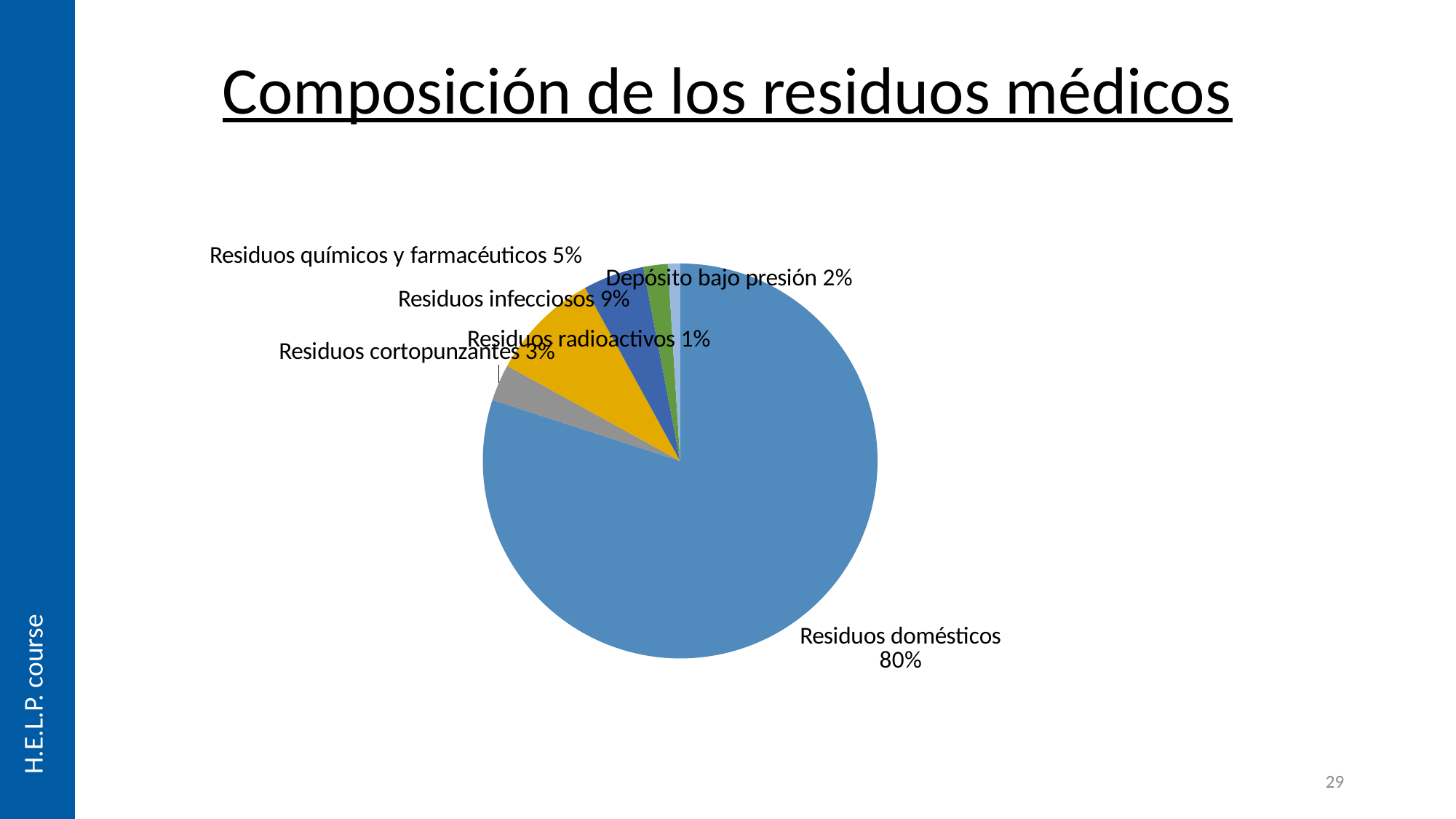
What share of the pie is Residuos químicos y farmacéuticos? 5% What is the difference in percentage points between Residuos infecciosos and Residuos químicos y farmacéuticos? 4% Which category has the largest slice of the pie? Residuos domésticos Which category has the smallest slice of the pie? Residuos radioactivos What share of the pie is Residuos infecciosos? 9% What share of the pie is Residuos radioactivos? 1% What type of chart is shown on the slide? Pie chart Which is larger, Residuos cortopunzantes or Depósito bajo presión? Residuos cortopunzantes How many categories are shown in the pie chart? 6